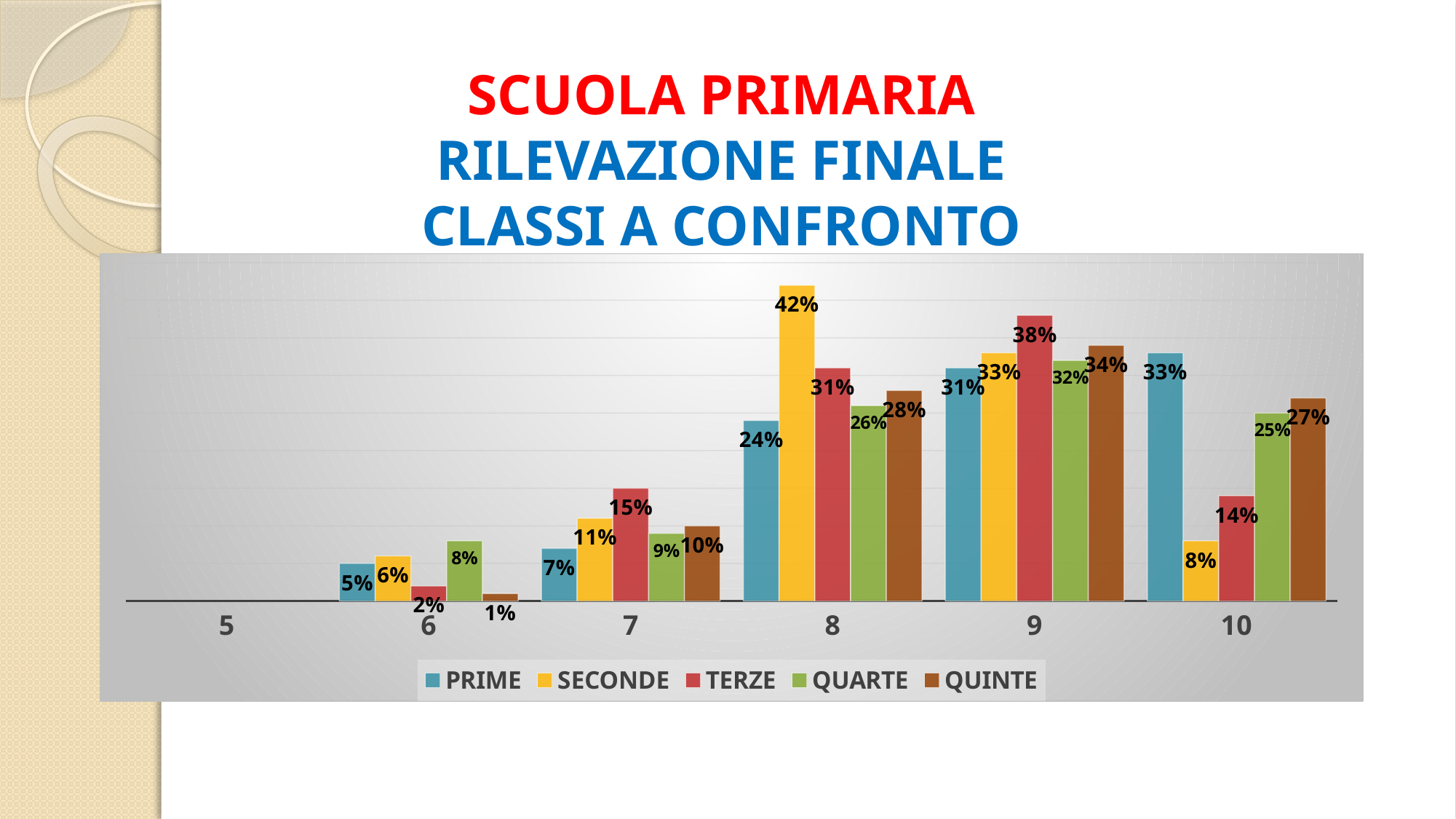
Which series is shown in yellow in the legend? SECONDE What kind of chart is shown on the slide? Bar chart What is the value for TERZE at category 7? 15% Which series has the highest value at category 9? TERZE What is the difference between the SECONDE and PRIME values at category 8? 18% Which is larger at category 6: the QUARTE value or the SECONDE value? QUARTE How many series does the legend list? 5 What is the value for PRIME at category 10? 33% How many categories are shown on the x axis? 6 What is the value for QUINTE at category 6? 1% What is the value for SECONDE at category 8? 42% Which series has the lowest value at category 10? SECONDE